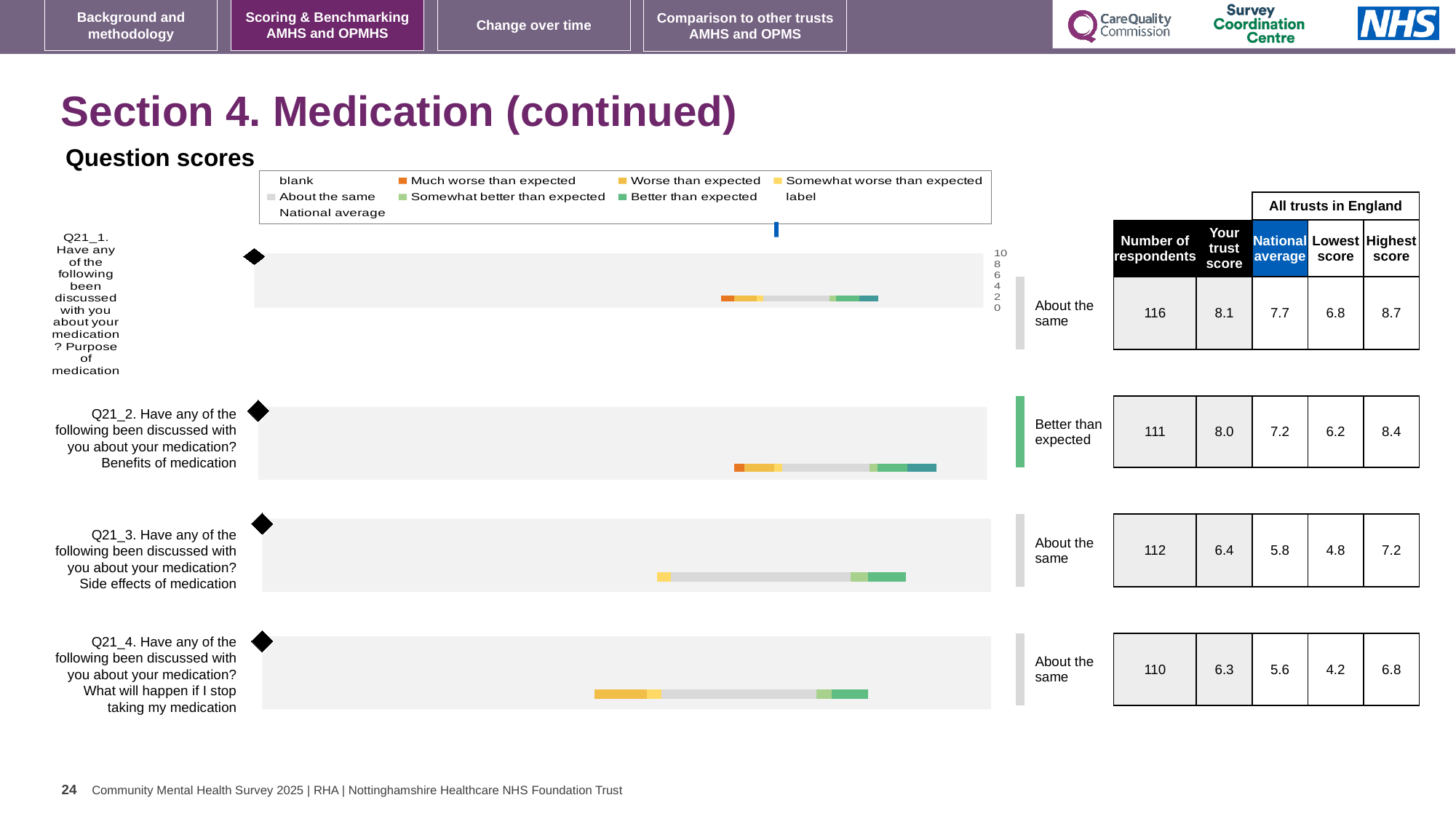
What kind of chart is used to show the question scores for Q21_1 to Q21_4? Bar chart For the Q21_1 chart (Purpose of medication), what is the Number of respondents? 116 For the Q21_3 chart (Side effects of medication), what is the National average? 5.8 For the Q21_2 chart, which is larger: 'Your trust score' or the National average? Your trust score Which Q21 question has the highest 'Your trust score'? Q21_1 (Purpose of medication) What benchmark category is shown next to the Q21_2 chart (Benefits of medication)? Better than expected For the Q21_4 chart, what is the Highest score among all trusts in England? 6.8 In the legend, what colour represents 'Much worse than expected'? Orange For the Q21_1 chart, what is the difference between 'Your trust score' and the National average? 0.4 How many question score charts (Q21 items) are shown on the slide? 4 Which Q21 question has the lowest 'Your trust score'? Q21_4 (What will happen if I stop taking my medication) For the Q21_2 chart (Benefits of medication), what is the 'Your trust score' value? 8.0